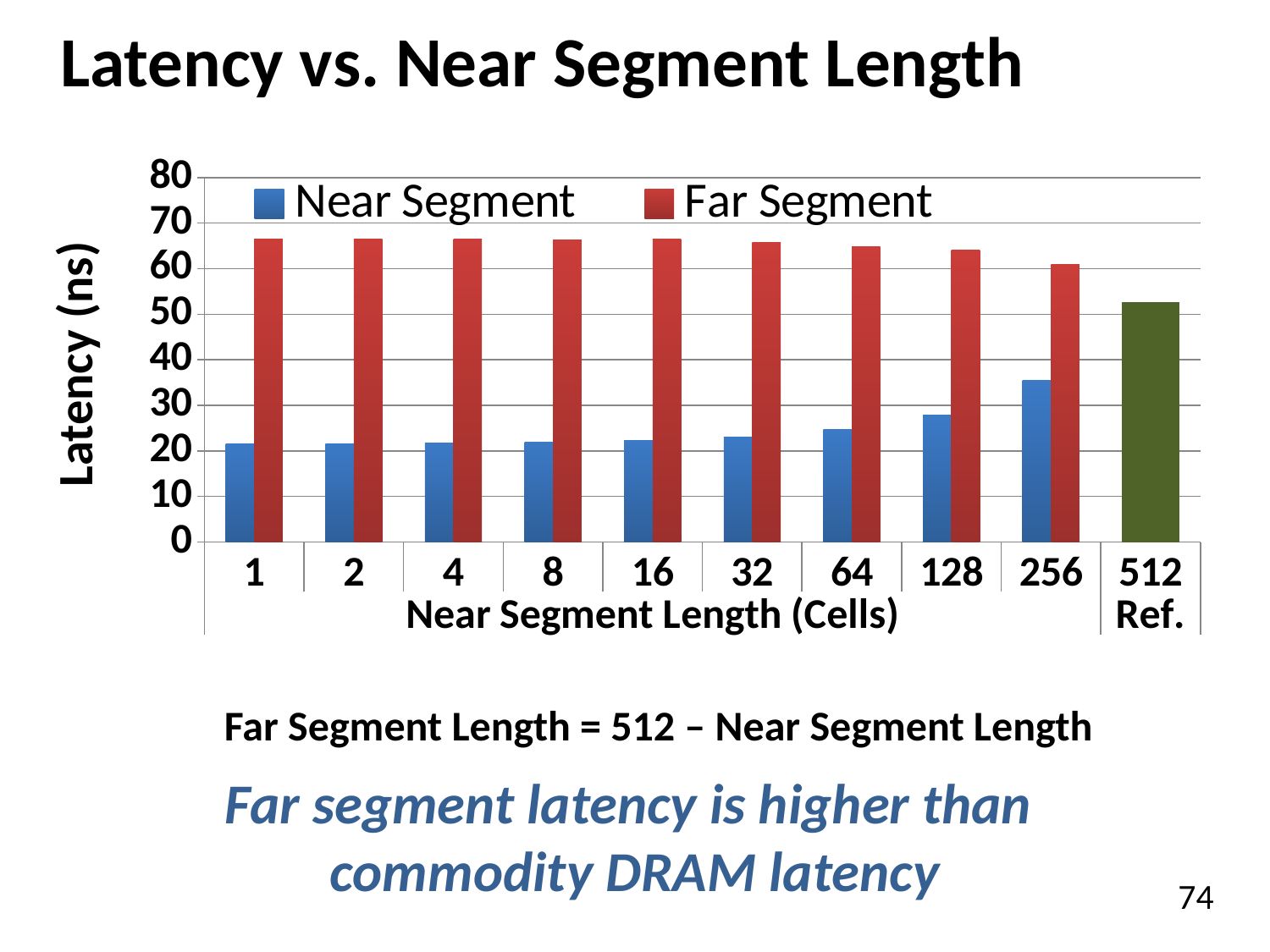
At a near segment length of 1, which is larger: the Near Segment latency or the Far Segment latency? Far Segment At which near segment length is the Near Segment latency highest? 256 What is the title of the y axis? Latency (ns) What kind of chart is shown on the slide? bar chart How many series does the chart legend list? 2 Is the Near Segment latency at a near segment length of 256 greater or less than 30? greater Does the Near Segment latency rise or fall as the near segment length increases from 1 to 256? rise Is the Near Segment latency at a near segment length of 1 greater or less than 30? less Which two series are listed in the chart legend? Near Segment and Far Segment Is the latency of the 512 Ref. bar greater or less than 60? less How many Near Segment Length values (excluding 512 Ref.) are shown on the x axis? 9